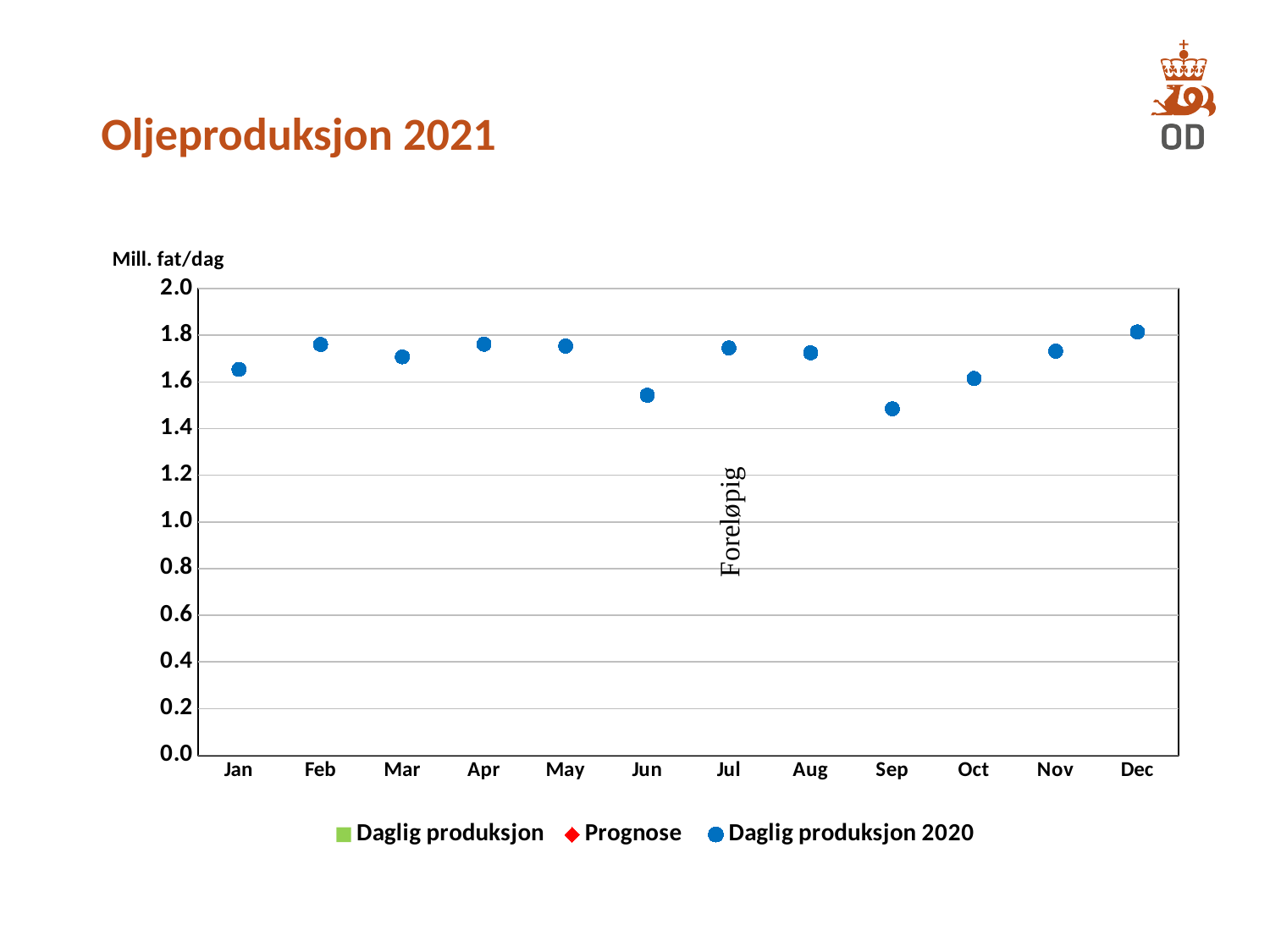
What unit is shown on the y axis label? Mill. fat/dag Is the value for Feb (Daglig produksjon 2020) greater or less than 1.6? greater Which is larger for Daglig produksjon 2020: Jan or Feb? Feb Which month has the highest value for Daglig produksjon 2020? Dec Is the value for Jun (Daglig produksjon 2020) greater or less than 1.6? less Is the value for Sep (Daglig produksjon 2020) greater or less than 1.6? less Which is larger for Daglig produksjon 2020: Jun or Sep? Jun Which month has the lowest value for Daglig produksjon 2020? Sep How many series does the legend list? 3 How many months are plotted along the x axis? 12 What kind of chart is shown on the slide? Scatter (dot) chart What is the title of the chart? Oljeproduksjon 2021